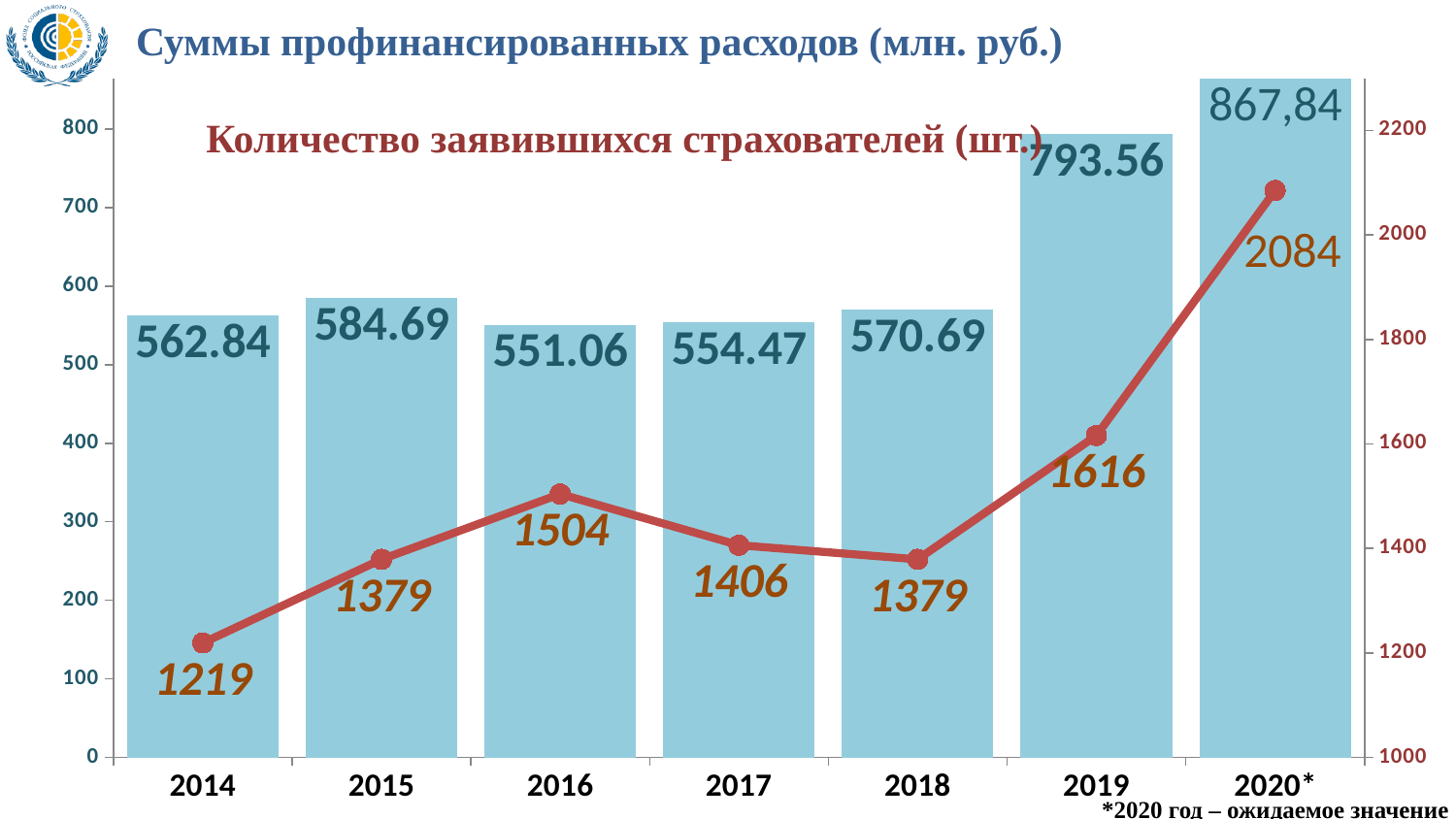
Which year has the lowest number of insurers on the line? 2014 What is the funded expenses value shown for 2020*? 867,84 What is the difference in funded expenses between 2019 and 2018? 222.87 Which year has the highest funded expenses bar? 2020* What does the footnote say about the 2020 value? *2020 год – ожидаемое значение What kind of chart is shown on the slide? Combined bar and line chart What is the funded expenses value (Суммы профинансированных расходов) for 2016? 551.06 How many years are shown on the x axis? 7 What is the difference in the number of insurers between 2020* and 2019? 468 What is the number of insurers (Количество заявившихся страхователей) for 2019? 1616 Which year has higher funded expenses, 2015 or 2017? 2015 Does the number of insurers rise or fall from 2018 to 2020*? rise